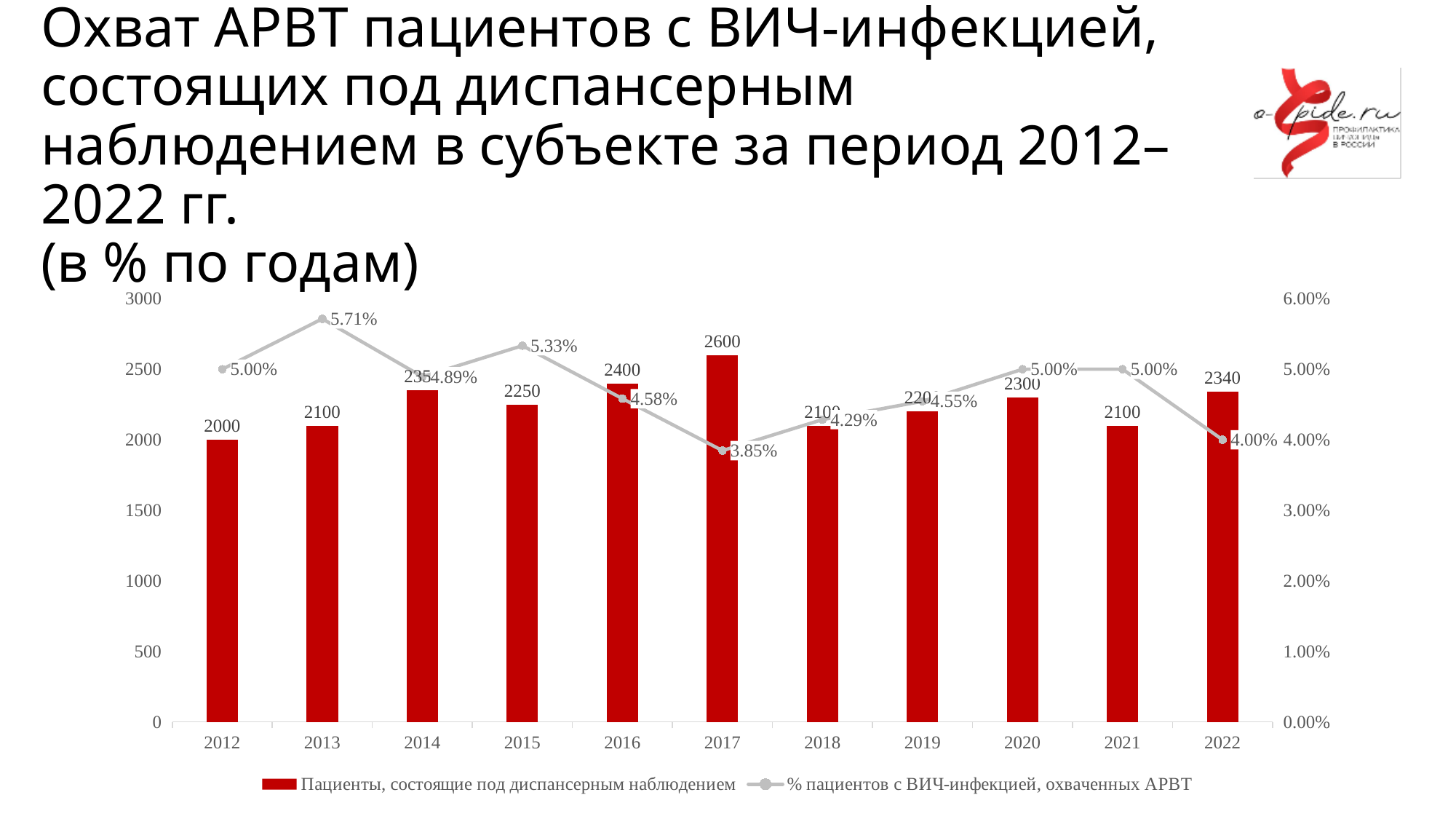
What colour are the bars for patients under dispensary observation? Red Is the percentage of patients covered by ART in 2015 greater or less than 5.00%? greater What is the number of patients under dispensary observation in 2022? 2340 In which year is the number of patients under dispensary observation the highest? 2017 Which year has more patients under dispensary observation, 2016 or 2021? 2016 How many years are shown on the x axis of the chart? 11 What is the number of patients under dispensary observation in 2017? 2600 In which year is the percentage of patients covered by ART the lowest? 2017 What percentage of HIV patients were covered by ART in 2017? 3.85% What percentage of HIV patients were covered by ART in 2013? 5.71% How many series does the legend list? 2 What is the difference in the number of patients under dispensary observation between 2017 and 2012? 600